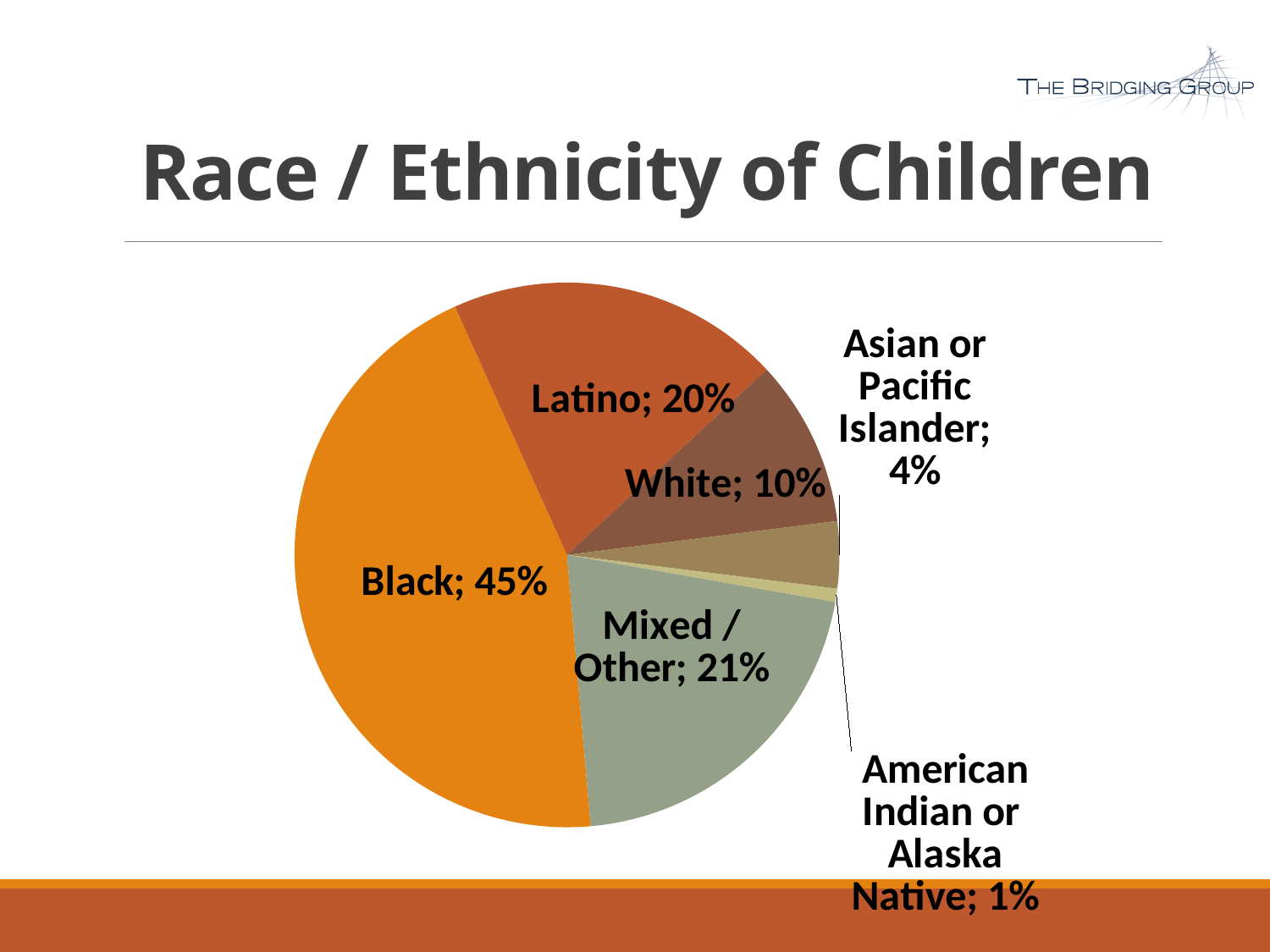
What percentage of children are American Indian or Alaska Native? 1% What is the difference in percentage points between the Black and Latino shares? 25 What percentage of children are Latino? 20% How many categories are shown in the pie chart? 6 What percentage of children are White? 10% What percentage of children are Asian or Pacific Islander? 4% What is the title of the chart? Race / Ethnicity of Children Which is larger, the share for Mixed / Other or the share for Latino? Mixed / Other Which race/ethnicity category has the smallest share? American Indian or Alaska Native What percentage of children are Black? 45% Which race/ethnicity category has the largest share? Black What type of chart is shown on the slide? Pie chart